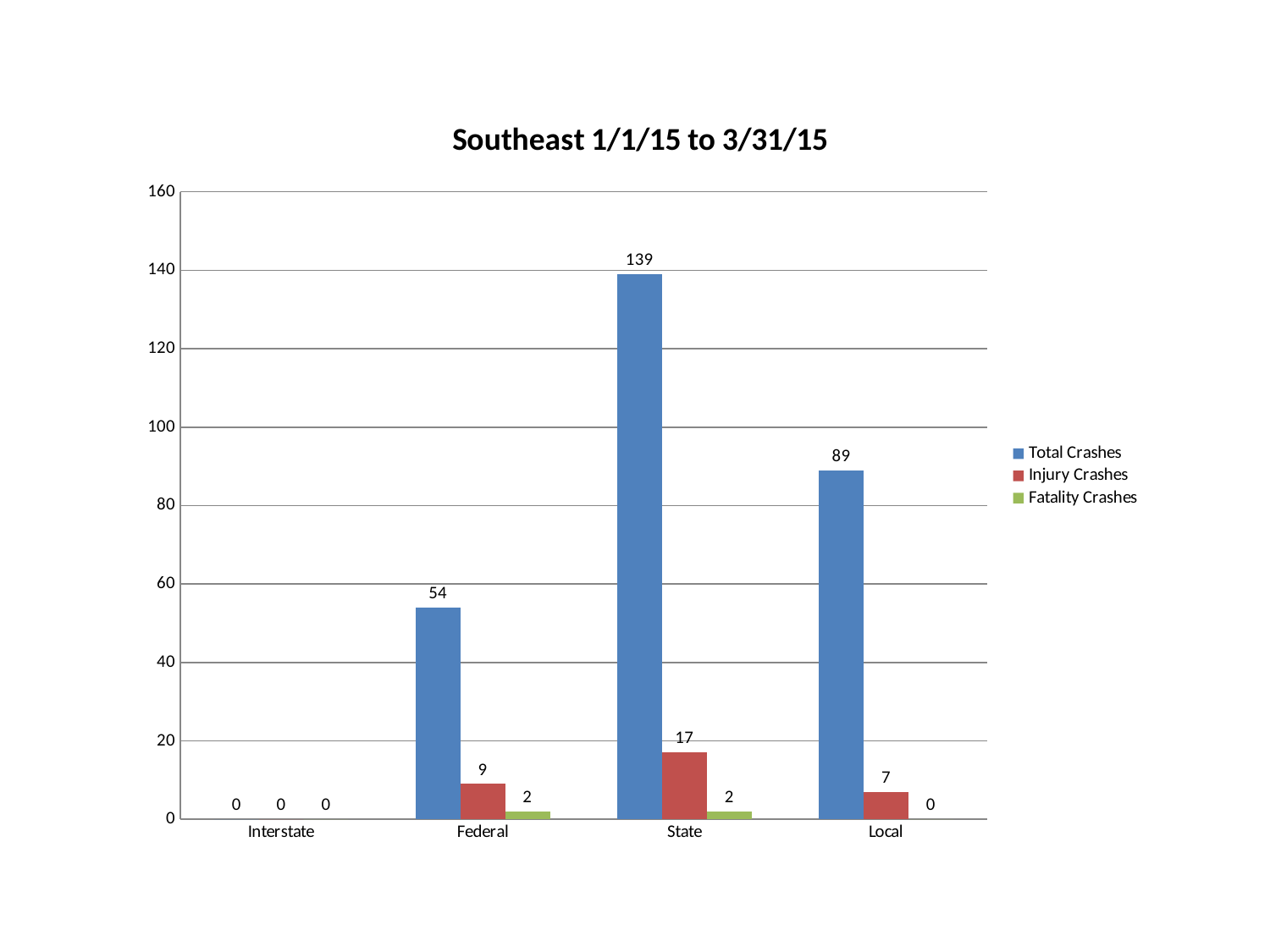
Which series is shown in green in the legend? Fatality Crashes What kind of chart is shown on the slide? Bar chart What is the value of Injury Crashes for Federal? 9 What is the title of the chart? Southeast 1/1/15 to 3/31/15 How many series does the legend list? 3 Which category has the lowest Injury Crashes? Interstate Which category has the highest Total Crashes? State What is the value of Fatality Crashes for Local? 0 How many categories are shown on the x axis? 4 Which is larger: Injury Crashes for State or Injury Crashes for Local? State What is the difference between Total Crashes for State and Total Crashes for Local? 50 What is the value of Total Crashes for State? 139